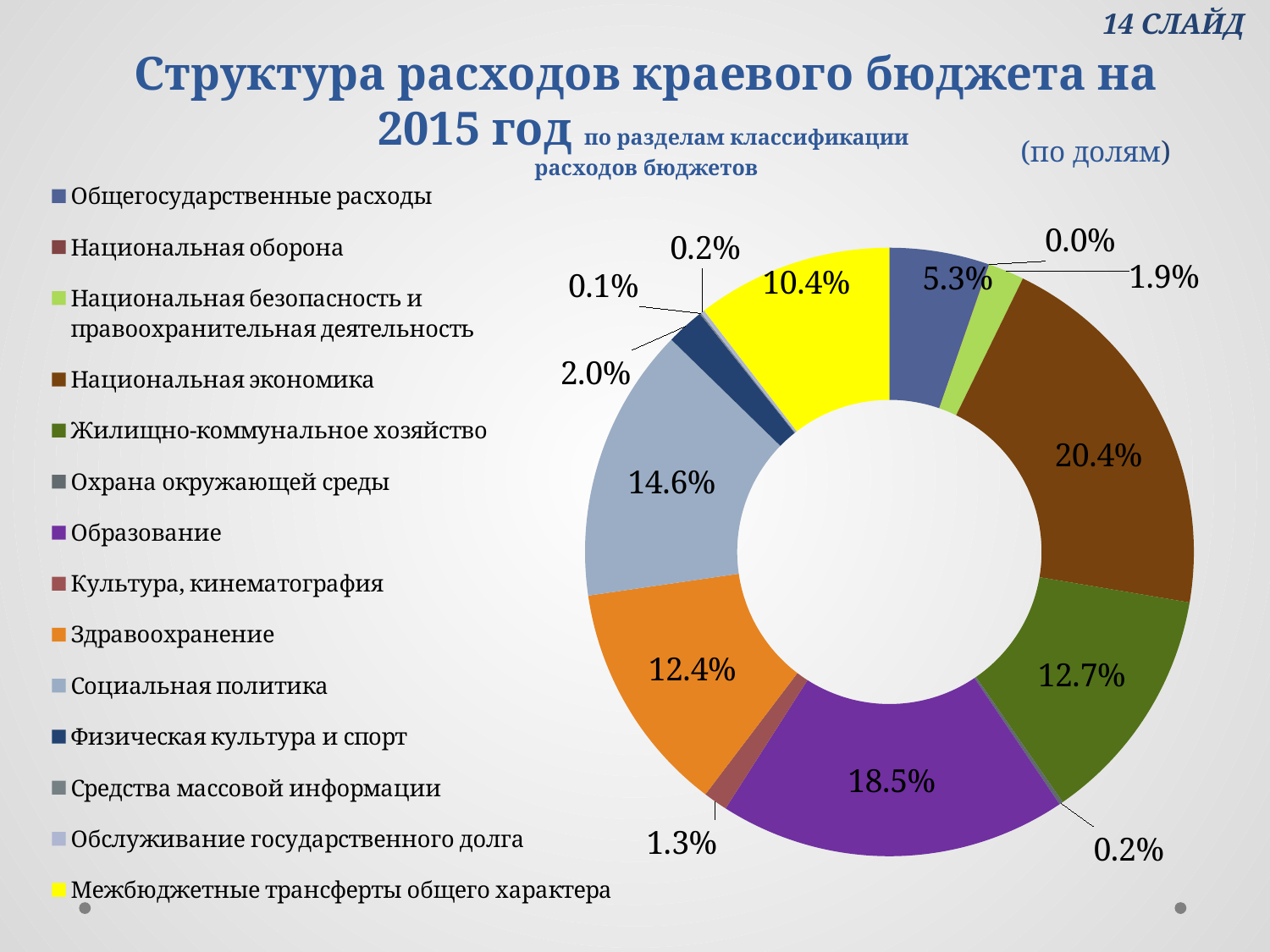
By how many percentage points does the share of Национальная экономика exceed the share of Образование? 1.9 percentage points Which category has the smallest share of expenditure? Национальная оборона What share is shown for Социальная политика? 14.6% What kind of chart is shown on the slide? doughnut (pie) chart Which category has the largest share of expenditure? Национальная экономика What share is shown for Общегосударственные расходы? 5.3% How many categories does the legend of the chart list? 14 What share is shown for Образование? 18.5% What share is shown for Межбюджетные трансферты общего характера? 10.4% Which has the larger share: Жилищно-коммунальное хозяйство or Здравоохранение? Жилищно-коммунальное хозяйство What share of the budget expenditure goes to Национальная экономика? 20.4% What share is shown for Здравоохранение? 12.4%